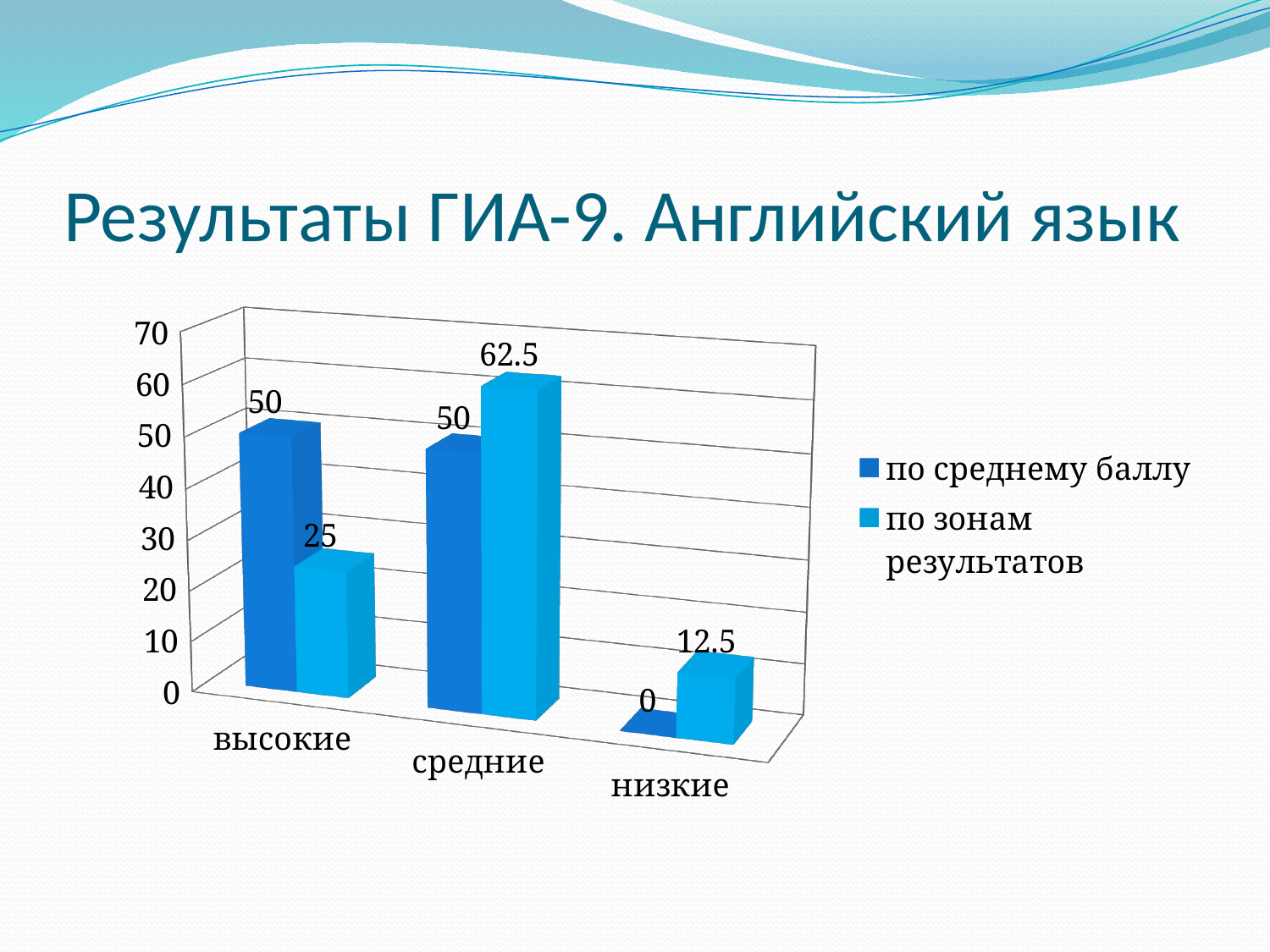
What is the value for "низкие" in the "по среднему баллу" series? 0 How many series does the legend list? 2 What is the difference between the "по зонам результатов" values for "средние" and "высокие"? 37.5 How many categories are shown on the x axis? 3 What is the value for "высокие" in the "по среднему баллу" series? 50 Which category has the lowest value in the "по среднему баллу" series? низкие What kind of chart is shown on the slide? bar chart What is the value for "средние" in the "по зонам результатов" series? 62.5 For "высокие", which series has the larger value: "по среднему баллу" or "по зонам результатов"? по среднему баллу What is the value for "низкие" in the "по зонам результатов" series? 12.5 Which category has the highest value in the "по зонам результатов" series? средние What is the title of the slide? Результаты ГИА-9. Английский язык